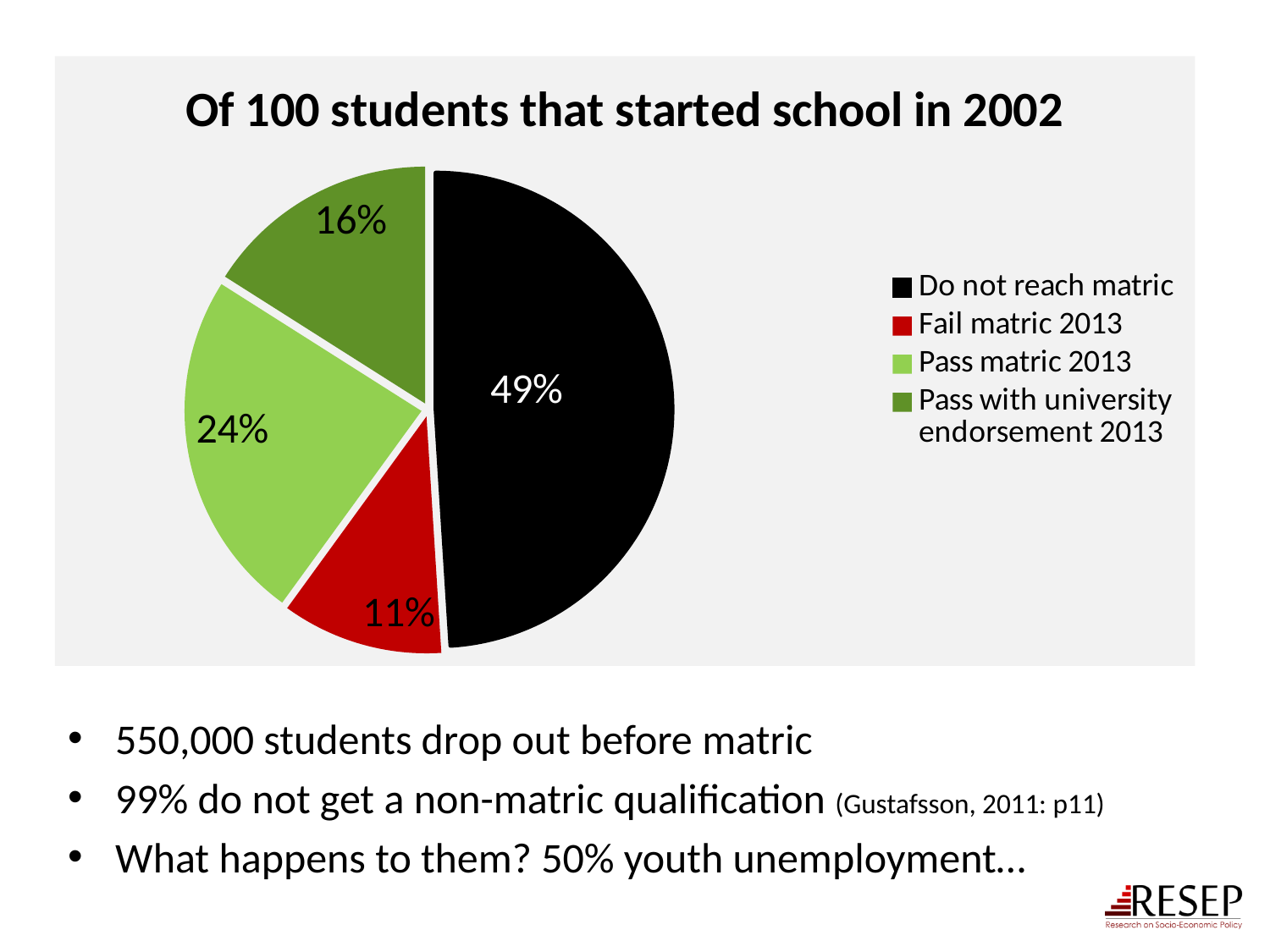
Which is larger: the share for 'Pass matric 2013' or the share for 'Pass with university endorsement 2013'? Pass matric 2013 What percentage of students fail matric 2013 according to the chart? 11% Which category has the largest slice of the pie? Do not reach matric How many categories does the pie chart show? 4 What percentage is shown for 'Pass with university endorsement 2013'? 16% What is the title of the chart? Of 100 students that started school in 2002 What type of chart is shown on the slide? Pie chart What colour is the slice for 'Fail matric 2013'? Red What is the difference in percentage points between 'Do not reach matric' and 'Pass matric 2013'? 25 What share of the pie is 'Pass matric 2013'? 24% What share of the pie is labelled 'Do not reach matric'? 49% Which category has the smallest slice of the pie? Fail matric 2013